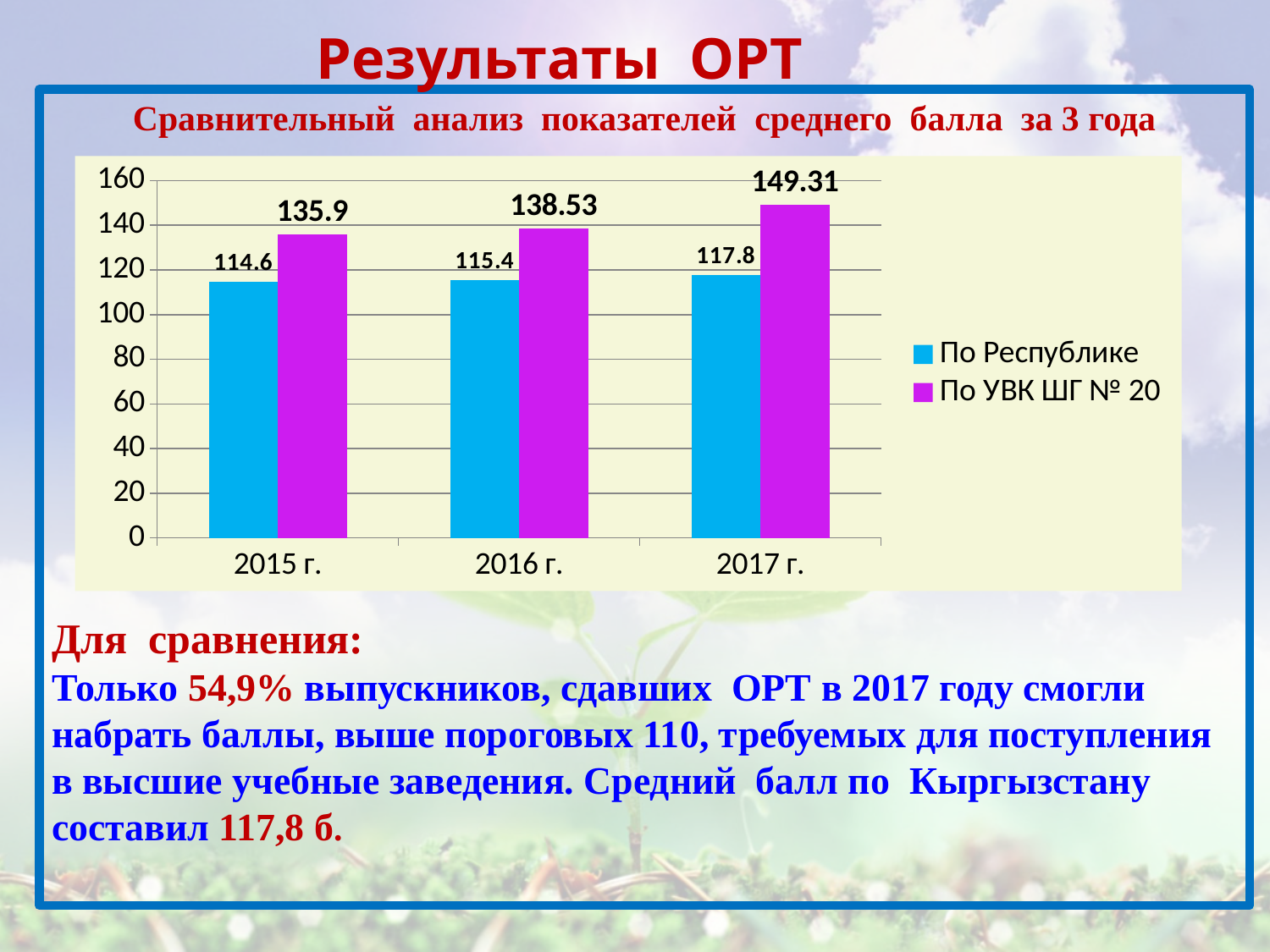
In which year is the value for По Республике the lowest? 2015 г. Do the values for По УВК ШГ № 20 rise or fall from 2015 г. to 2017 г.? rise What is the difference between По УВК ШГ № 20 and По Республике in 2015 г.? 21.3 How many series does the legend list? 2 In which year is the value for По УВК ШГ № 20 the highest? 2017 г. What is the value for По УВК ШГ № 20 in 2017 г.? 149.31 What is the value for По Республике in 2017 г.? 117.8 Which is larger in 2016 г.: По Республике or По УВК ШГ № 20? По УВК ШГ № 20 What is the value for По УВК ШГ № 20 in 2016 г.? 138.53 What is the difference between По УВК ШГ № 20 and По Республике in 2017 г.? 31.51 How many years are shown on the x axis? 3 What is the value for По Республике in 2015 г.? 114.6